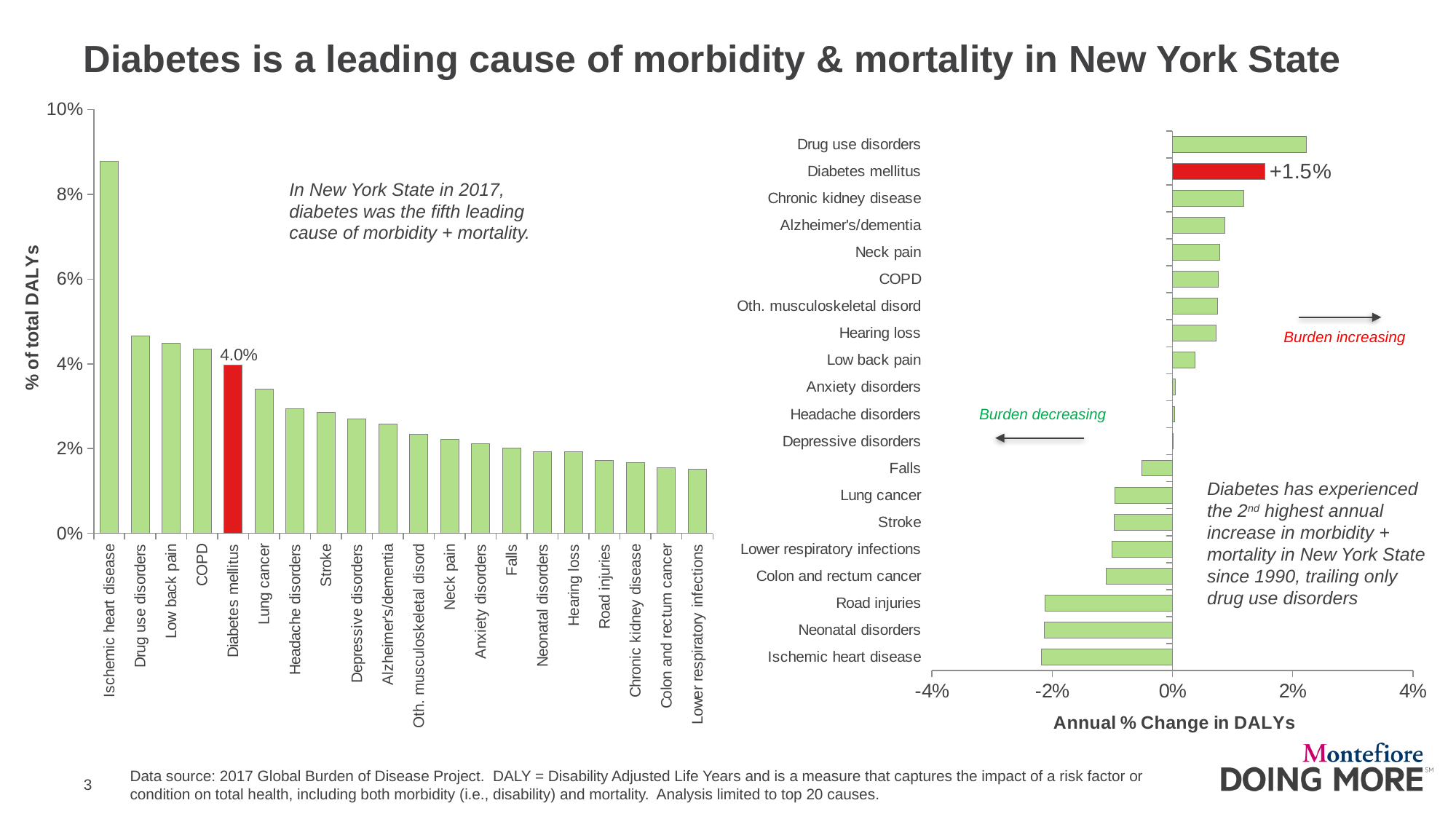
On the left chart (% of total DALYs), which is larger, Drug use disorders or Stroke? Drug use disorders What kind of chart is the right chart (Annual % Change in DALYs)? Bar chart On the left chart (% of total DALYs), what is the value for Diabetes mellitus? 4.0% On the right chart (Annual % Change in DALYs), which is larger, Chronic kidney disease or Low back pain? Chronic kidney disease On the right chart (Annual % Change in DALYs), is the value for Drug use disorders greater or less than 2%? greater On the left chart (% of total DALYs), is the value for Ischemic heart disease greater or less than 8%? greater On the right chart (Annual % Change in DALYs), is the value for Ischemic heart disease greater or less than -2%? less How many categories are shown on the left chart (% of total DALYs)? 20 On the right chart (Annual % Change in DALYs), what is the value for Diabetes mellitus? +1.5% On the right chart (Annual % Change in DALYs), which category has the highest value? Drug use disorders On the left chart (% of total DALYs), which category has the highest value? Ischemic heart disease